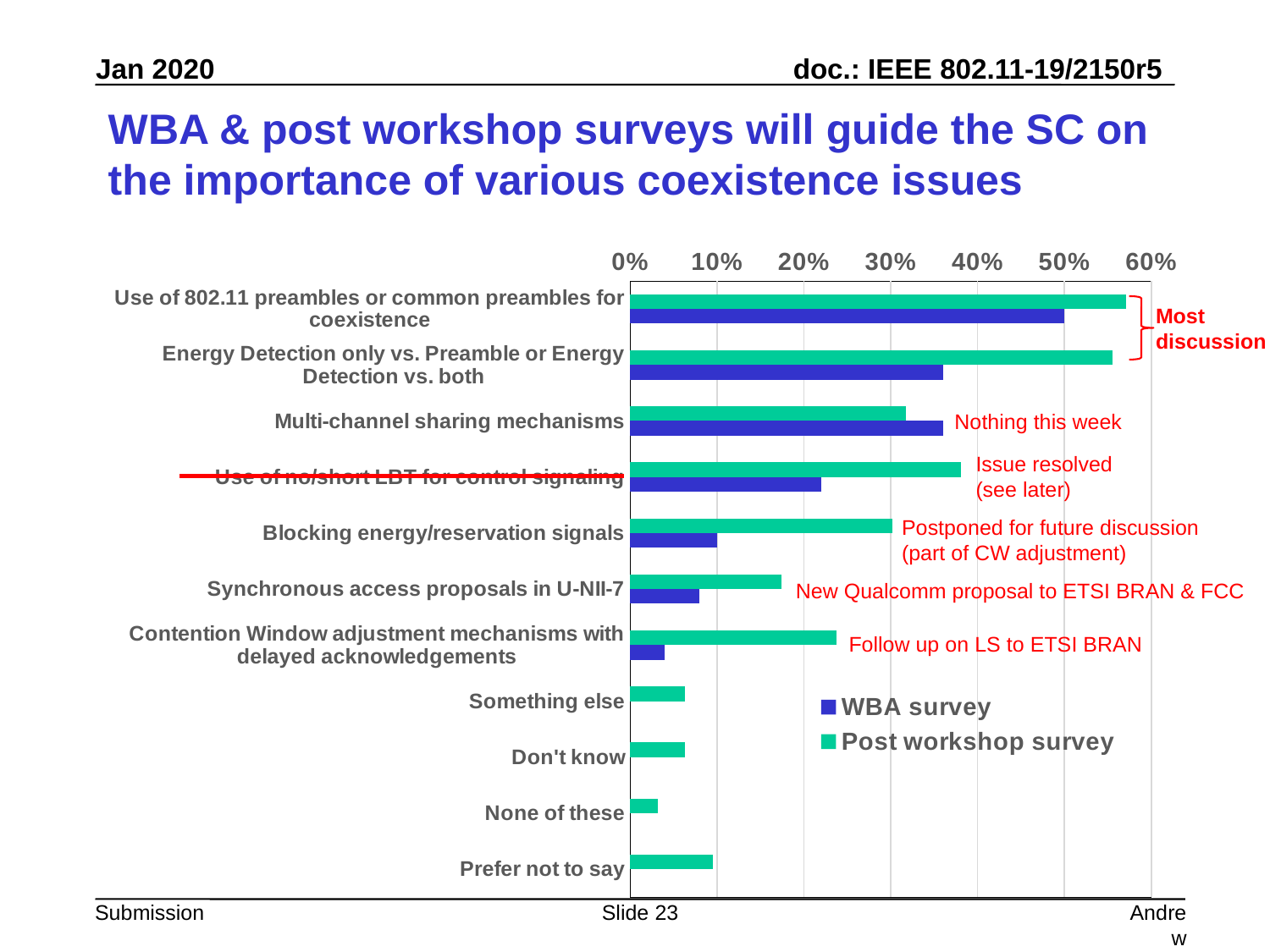
Is the Post workshop survey value for Energy Detection only vs. Preamble or Energy Detection vs. both greater or less than 50%? greater Which category has the highest WBA survey value? Use of 802.11 preambles or common preambles for coexistence For Blocking energy/reservation signals, which series has the larger value, WBA survey or Post workshop survey? Post workshop survey What kind of chart is shown on the slide? Bar chart Which category has the lowest Post workshop survey value? None of these Which category has the highest Post workshop survey value? Use of 802.11 preambles or common preambles for coexistence Is the Post workshop survey value for Synchronous access proposals in U-NII-7 greater or less than 20%? less How many series does the legend list? 2 For Multi-channel sharing mechanisms, which series has the larger value, WBA survey or Post workshop survey? WBA survey Is the WBA survey value for Contention Window adjustment mechanisms with delayed acknowledgements greater or less than 10%? less Which colour represents the Post workshop survey series in the legend? Green How many categories are shown on the chart? 11